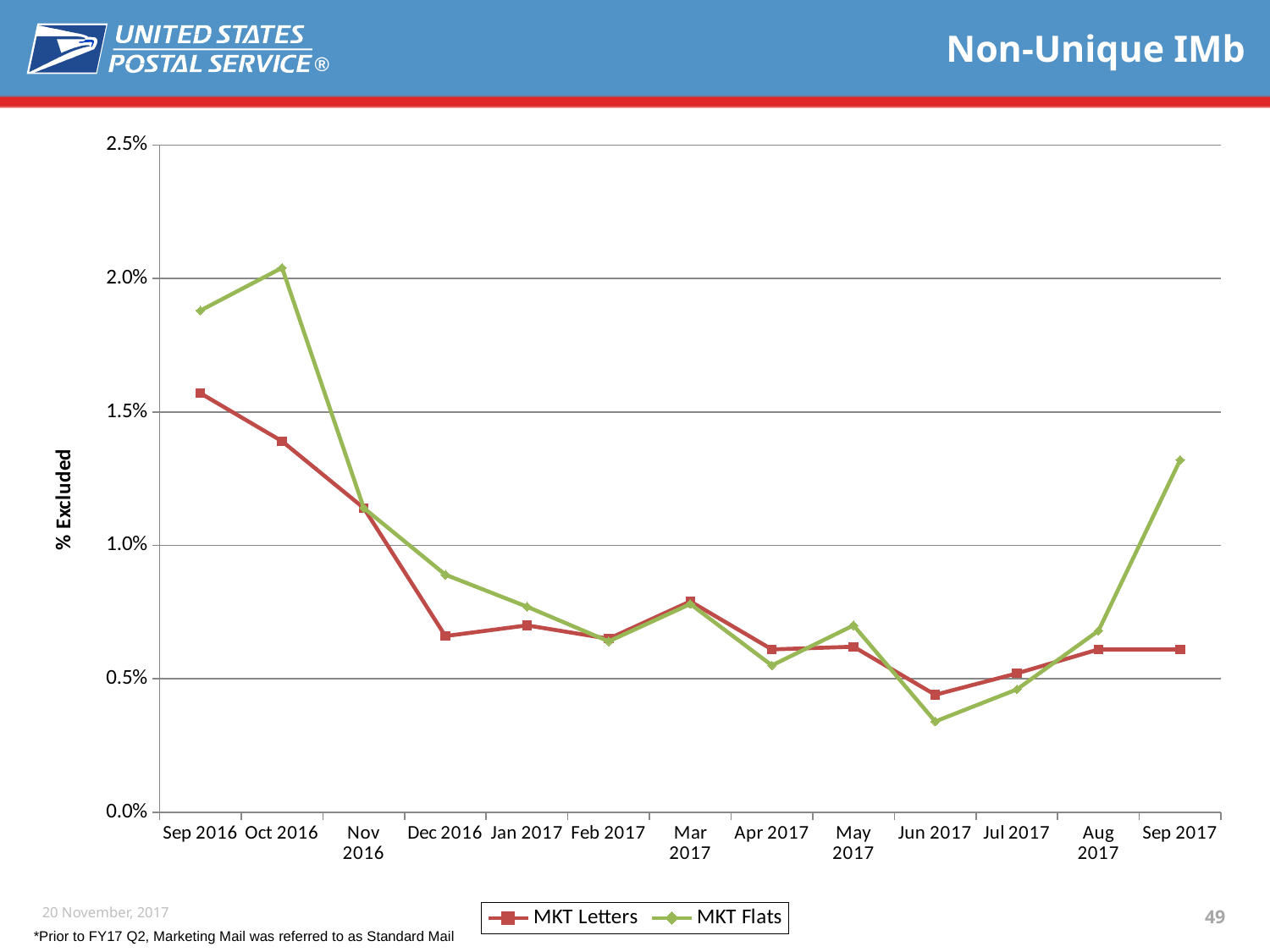
In which month does MKT Letters reach its highest value? Sep 2016 How many months are plotted along the x axis? 13 In which month does MKT Flats reach its lowest value? Jun 2017 What is the label on the vertical axis? % Excluded Is the value for MKT Flats in Jun 2017 greater or less than 0.5%? less In Sep 2017, which series has the higher value, MKT Letters or MKT Flats? MKT Flats What kind of chart is shown on the slide? line chart How many series does the legend list? 2 Is the value for MKT Flats in Oct 2016 greater or less than 2.0%? greater In which month does MKT Flats reach its highest value? Oct 2016 In which month does MKT Letters reach its lowest value? Jun 2017 Is the value for MKT Letters in Sep 2016 greater or less than 1.5%? greater